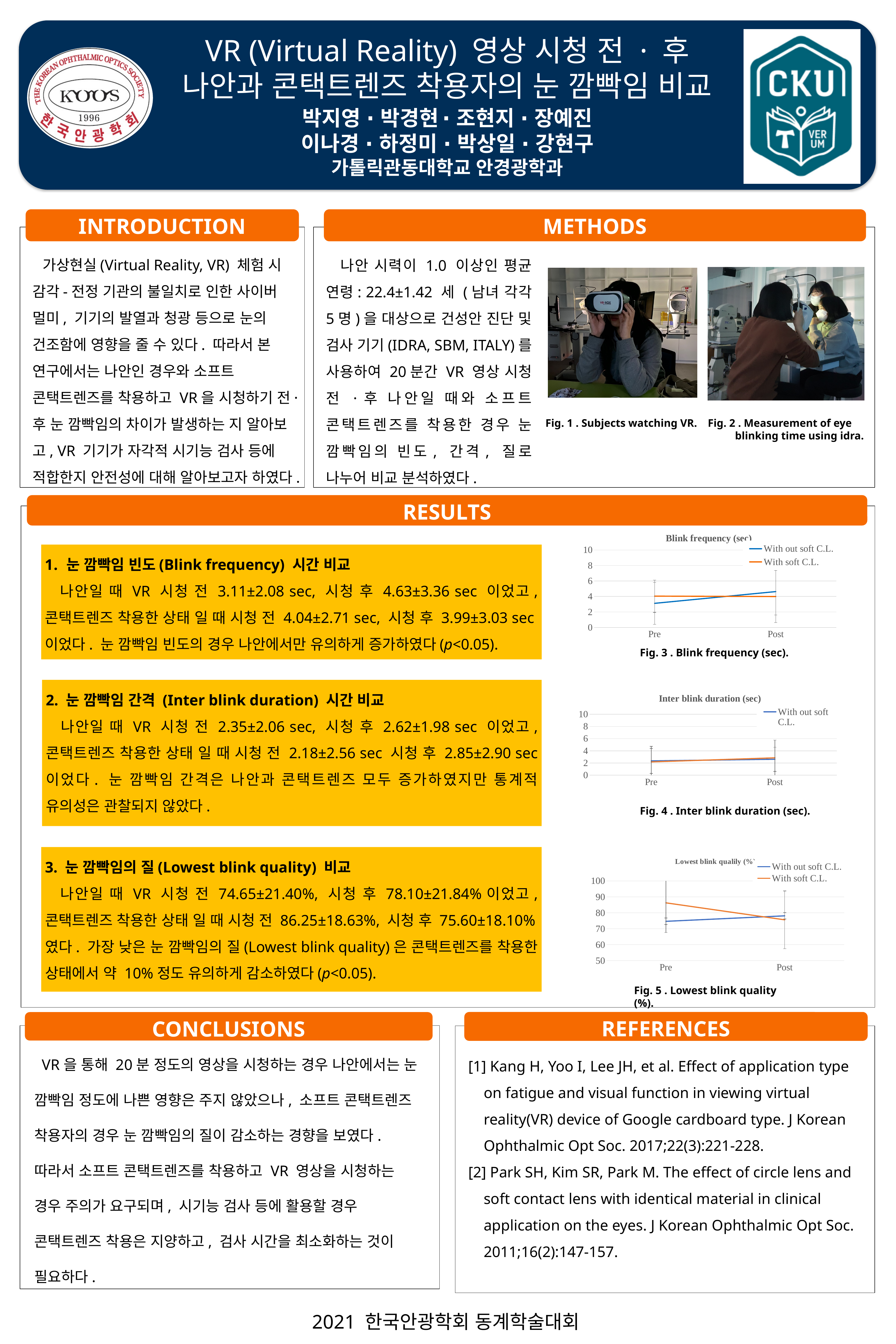
In the Blink frequency chart, does the 'With out soft C.L.' line rise or fall from Pre to Post? rise What colour is the 'With soft C.L.' line in the Lowest blink quality chart? orange How many series does the legend of the Blink frequency chart list? 2 What kind of chart is Fig. 3 (Blink frequency)? line chart How many categories are on the x axis of the Blink frequency chart? 2 In the Blink frequency chart, is the Pre value for 'With out soft C.L.' greater or less than 4? less What are the two x-axis categories in the Inter blink duration chart? Pre and Post In the Inter blink duration chart, is the Post value for 'With out soft C.L.' greater or less than 4? less In the Blink frequency chart, is the Post value for 'With soft C.L.' greater or less than 6? less In the Lowest blink quality chart, does the 'With soft C.L.' line rise or fall from Pre to Post? fall In the Lowest blink quality chart, which series has the higher Pre value, 'With out soft C.L.' or 'With soft C.L.'? With soft C.L.